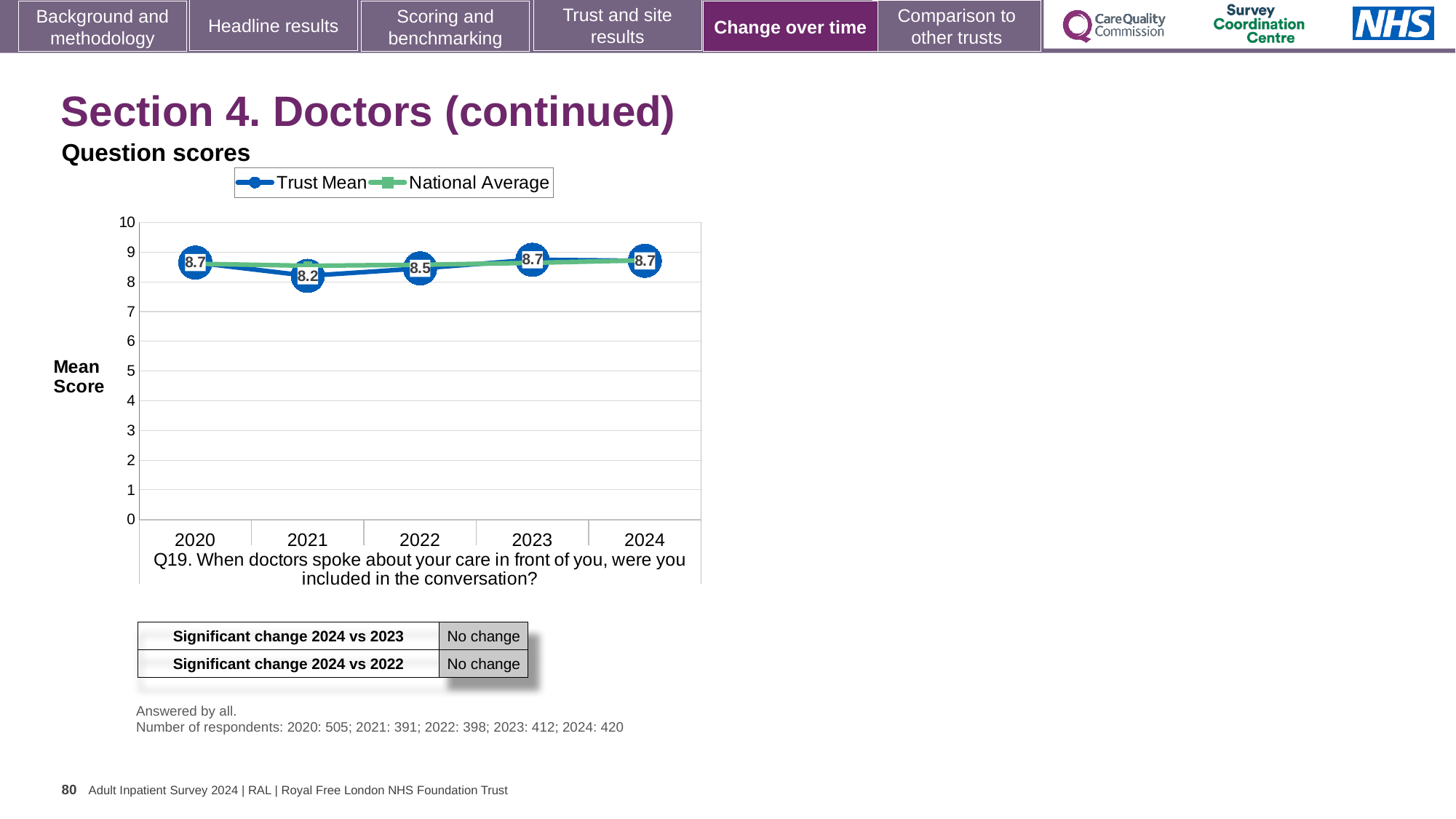
How many years are plotted on the x axis? 5 Which year has the higher Trust Mean score, 2021 or 2022? 2022 Does the Trust Mean score rise or fall from 2021 to 2023? Rise What is the Trust Mean score for 2021? 8.2 What is the label on the y axis of the chart? Mean Score What is the Trust Mean score for 2022? 8.5 What is the difference between the Trust Mean scores for 2020 and 2021? 0.5 What kind of chart is shown on the slide? Line chart In which year is the Trust Mean score lowest? 2021 How many series does the legend list? 2 Is the National Average value for 2021 greater or less than 8? greater What is the Trust Mean score for 2024? 8.7